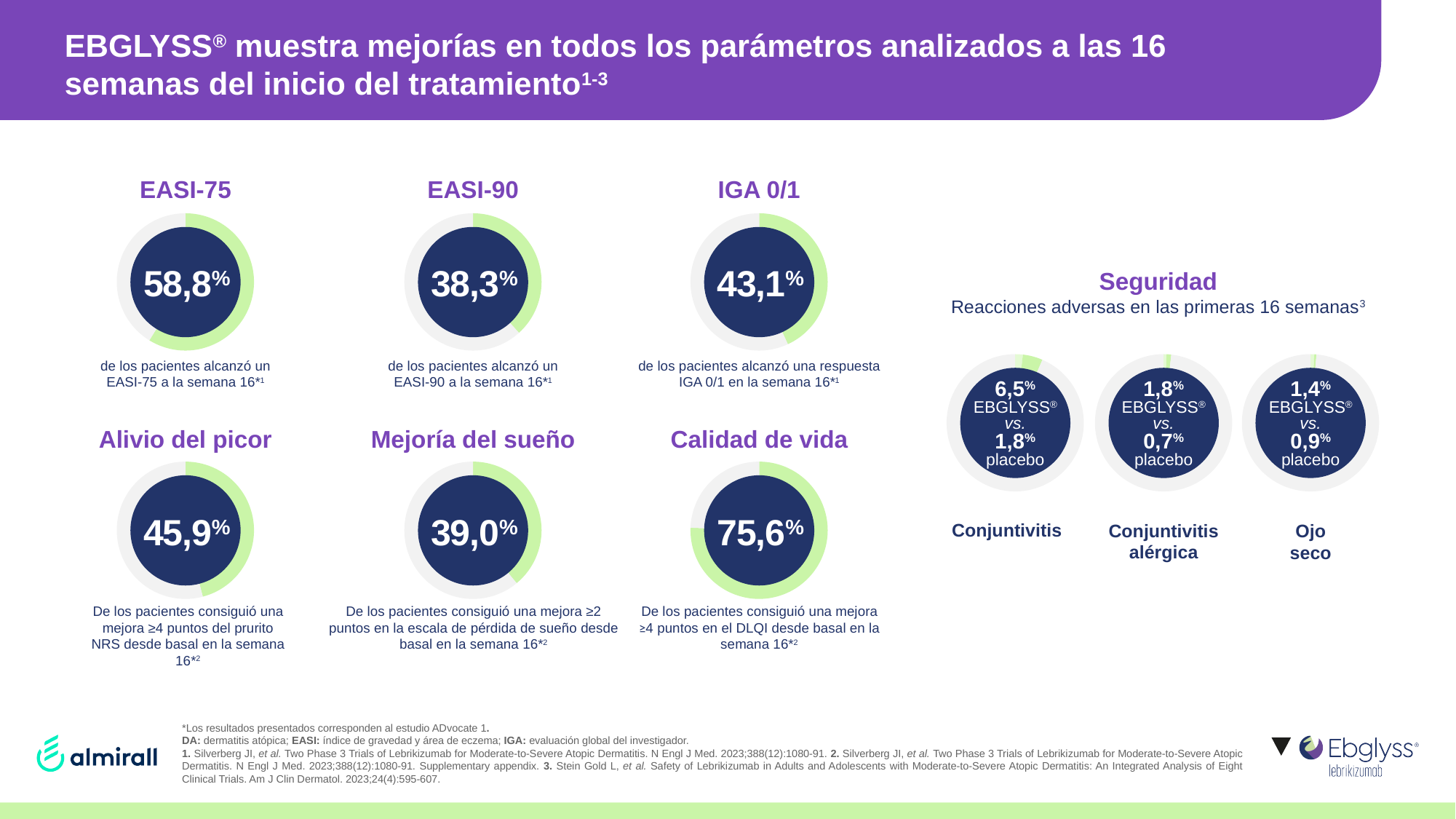
In the IGA 0/1 chart, what percentage of patients achieved an IGA 0/1 response at week 16? 43,1% In the Calidad de vida chart, what value is shown? 75,6% Among the six efficacy charts (EASI-75, EASI-90, IGA 0/1, Alivio del picor, Mejoría del sueño, Calidad de vida), which has the lowest value? EASI-90 In the Seguridad section, what is the placebo rate for Ojo seco? 0,9% What is the difference between the EASI-75 value and the EASI-90 value? 20,5% Among the six efficacy charts (EASI-75, EASI-90, IGA 0/1, Alivio del picor, Mejoría del sueño, Calidad de vida), which has the highest value? Calidad de vida How many adverse reactions are shown in the Seguridad section? 3 In the EASI-75 chart, what percentage of patients achieved EASI-75 at week 16? 58,8% In the Seguridad section, what is the EBGLYSS rate for Conjuntivitis? 6,5% In the EASI-90 chart, what value is shown? 38,3% Which is larger, the Alivio del picor value or the Mejoría del sueño value? Alivio del picor In the Seguridad section, what is the difference between the EBGLYSS and placebo rates for Conjuntivitis alérgica? 1,1%